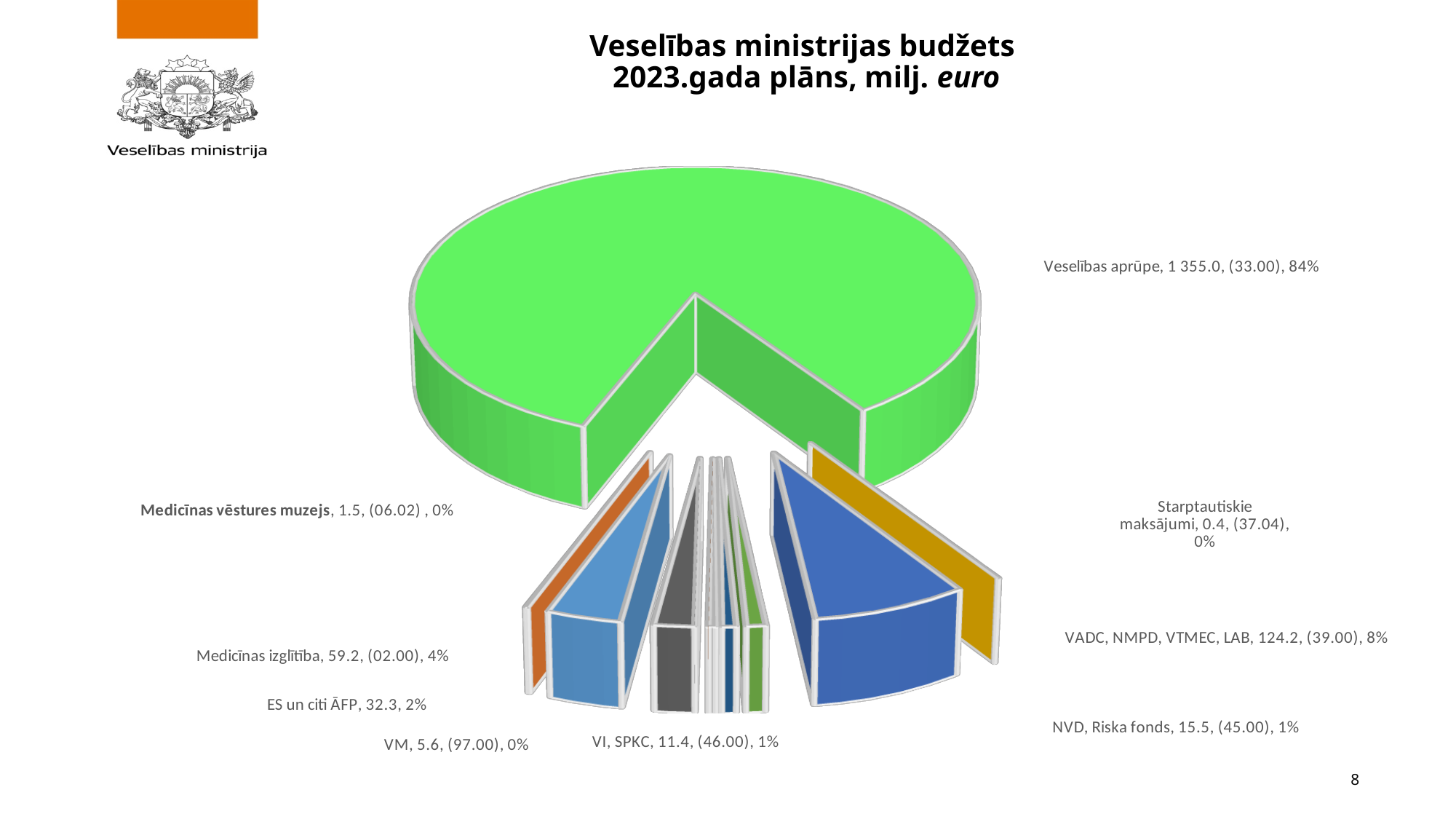
How many categories are shown in the pie chart? 9 What is the difference between the values for VADC, NMPD, VTMEC, LAB and Medicīnas izglītība? 65.0 What is the value for Medicīnas izglītība? 59.2 What kind of chart is shown on the slide? pie chart What is the value for ES un citi ĀFP? 32.3 Which category has the largest value? Veselības aprūpe What is the value for VADC, NMPD, VTMEC, LAB? 124.2 Which is larger, the value for NVD, Riska fonds or the value for VI, SPKC? NVD, Riska fonds What is the value for Veselības aprūpe? 1 355.0 What share of the pie does Veselības aprūpe represent? 84% Which category has the smallest value? Starptautiskie maksājumi What share of the pie does VADC, NMPD, VTMEC, LAB represent? 8%